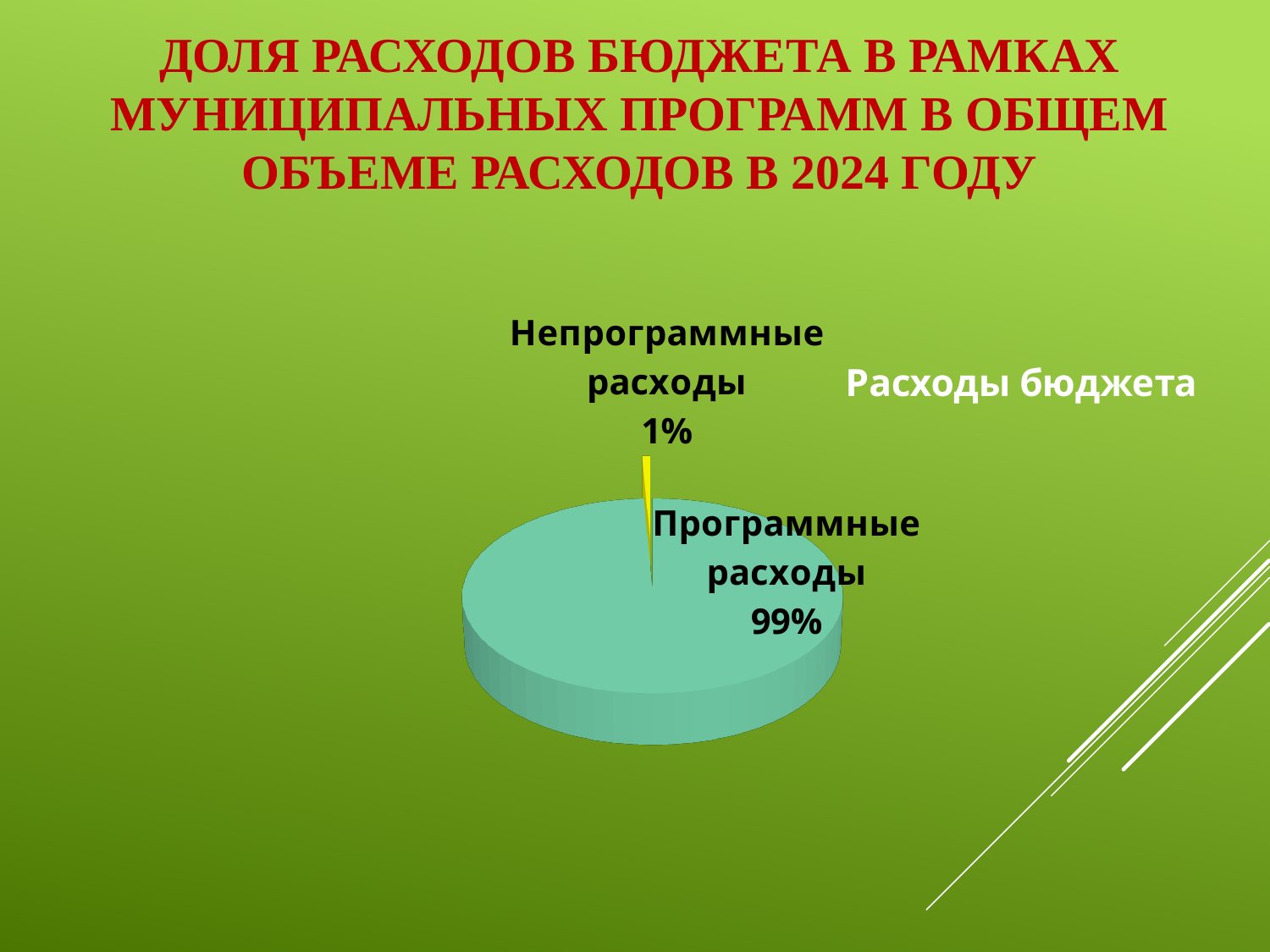
Which slice of the pie is the largest? Программные расходы What share of the pie is Программные расходы? 99% What kind of chart is shown on the slide? Pie chart Which is larger: Программные расходы or Непрограммные расходы? Программные расходы Which slice of the pie is the smallest? Непрограммные расходы What is the chart's title? Расходы бюджета What colour is the Непрограммные расходы slice? Yellow What is the difference between the shares of Программные расходы and Непрограммные расходы? 98% How many slices does the pie chart have? 2 What share of the pie is Непрограммные расходы? 1%